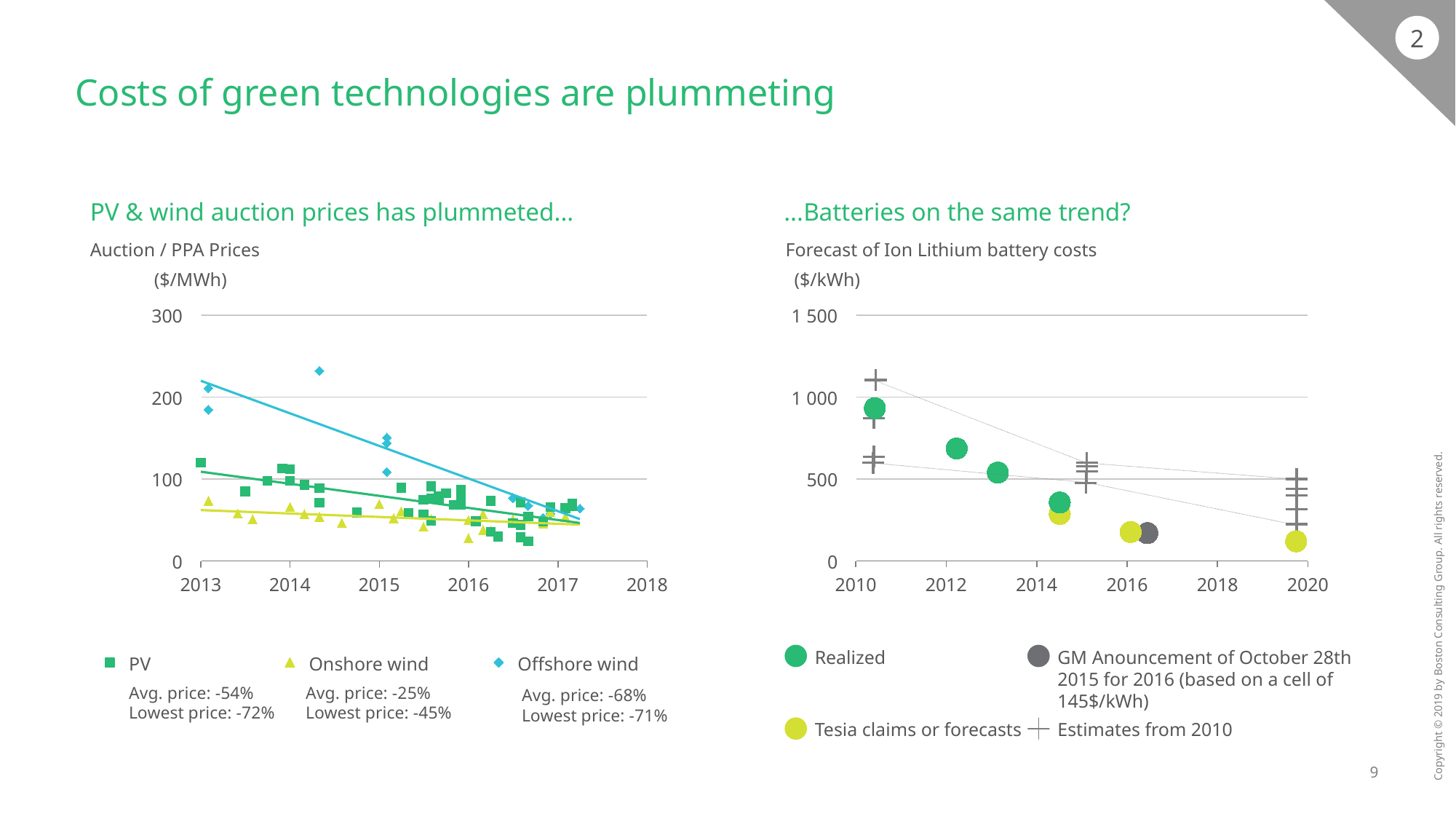
In the right chart, 'Forecast of Ion Lithium battery costs', which series is represented by the grey circle marker? GM Anouncement of October 28th 2015 for 2016 (based on a cell of 145$/kWh) How many series does the legend of the left chart, 'Auction / PPA Prices', list? 3 In the right chart, 'Forecast of Ion Lithium battery costs', is the Tesla claims or forecasts value for 2020 greater or less than 500 $/kWh? less In the right chart, 'Forecast of Ion Lithium battery costs', is the Realized value in 2010 greater or less than 500 $/kWh? greater How many series does the legend of the right chart, 'Forecast of Ion Lithium battery costs', list? 4 What type of chart is the left chart, 'Auction / PPA Prices'? scatter chart In the left chart, 'Auction / PPA Prices', do the trend lines for PV, onshore wind and offshore wind rise or fall from 2013 to 2017? fall In the left chart, 'Auction / PPA Prices', what average price change is shown for offshore wind? -68% What unit is shown on the y axis of the right chart, 'Forecast of Ion Lithium battery costs'? $/kWh In the left chart, 'Auction / PPA Prices', is the highest offshore wind point (around 2014) greater or less than 200 $/MWh? greater In the right chart, 'Forecast of Ion Lithium battery costs', do the Realized values rise or fall from 2010 to 2016? fall In the left chart, 'Auction / PPA Prices', what lowest price change is shown for PV? -72%